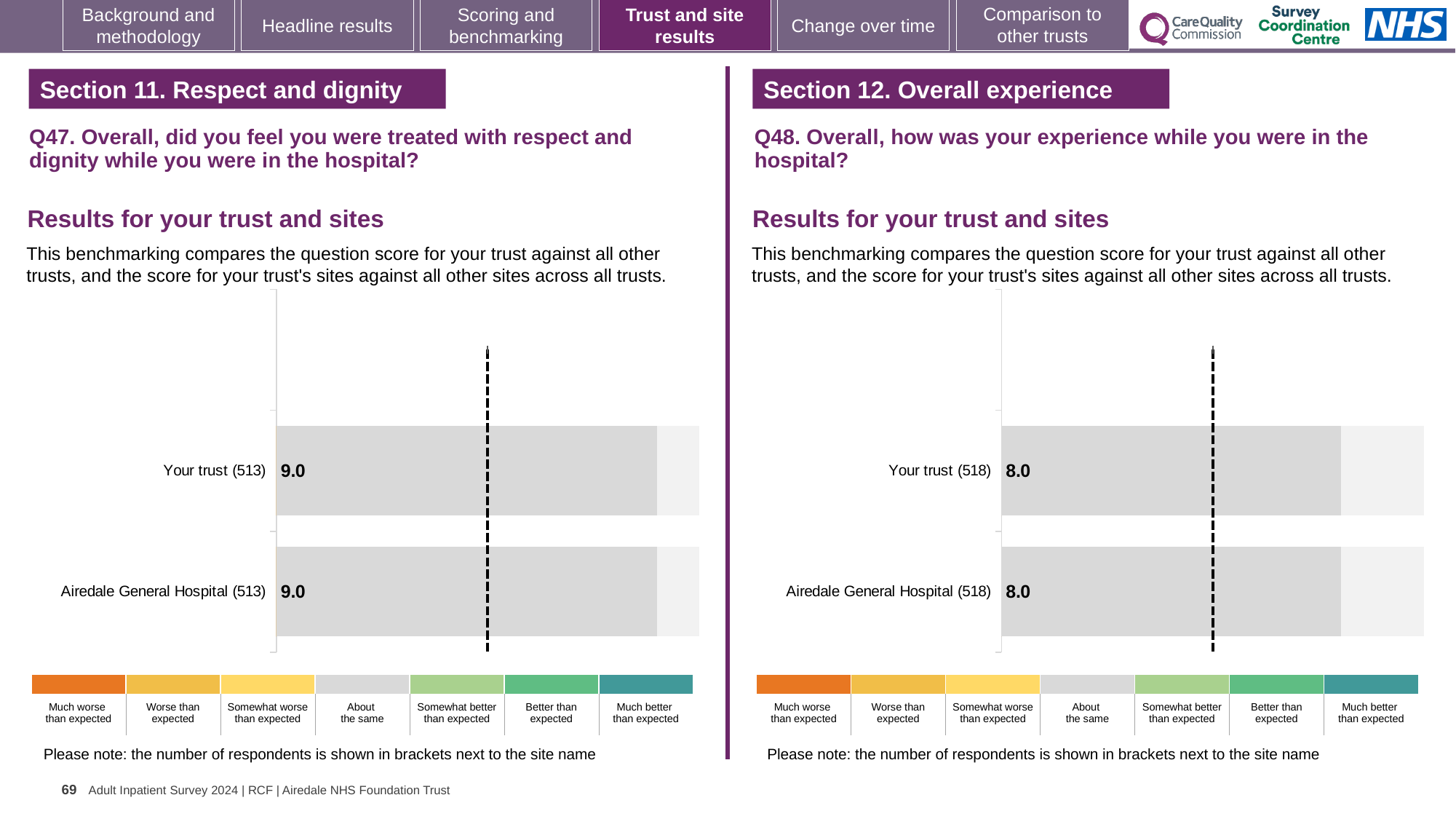
How many categories does the colour key below the Q47 chart on the left list? 7 In the Q47 chart on the left, what is the score for Your trust? 9.0 How many bars are plotted in the Q48 chart on the right? 2 What is the label of the leftmost category in the colour key below the Q48 chart on the right? Much worse than expected What kind of chart is used in the Q47 chart on the left? Bar chart In the Q48 chart on the right, how many respondents are shown in brackets for Airedale General Hospital? 518 In the Q47 chart on the left, what is the difference between the score for Your trust and the score for Airedale General Hospital? 0.0 In the Q47 chart on the left, what is the score for Airedale General Hospital? 9.0 In the Q48 chart on the right, what is the score for Your trust? 8.0 In the Q47 chart on the left, how many respondents are shown in brackets for Your trust? 513 Is the score for Your trust in the Q47 chart on the left larger than the score for Your trust in the Q48 chart on the right? Yes In the Q48 chart on the right, what is the score for Airedale General Hospital? 8.0